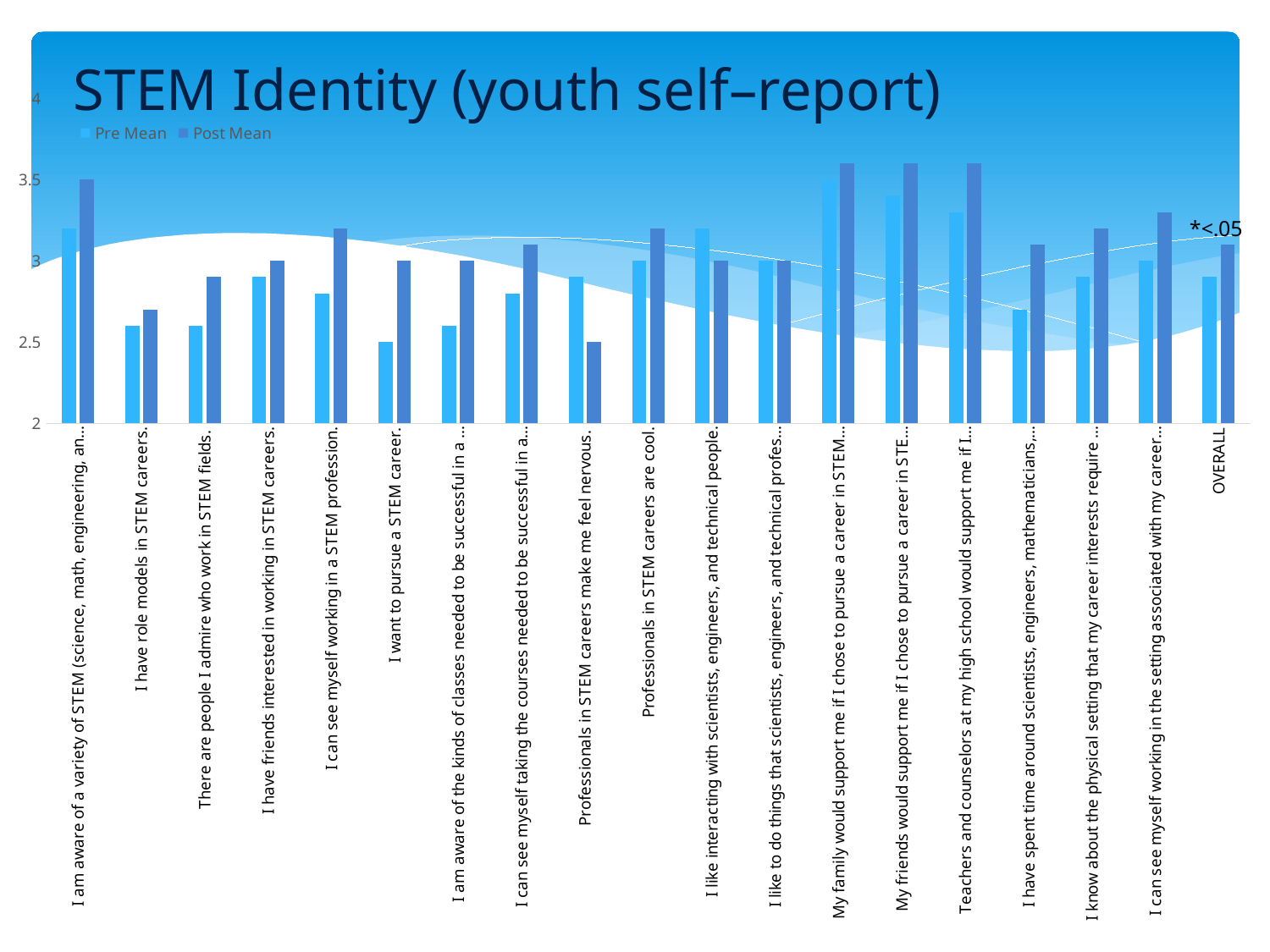
What are the two series named in the legend? Pre Mean and Post Mean How many categories are plotted along the x axis? 19 Is the Pre Mean for 'My friends would support me if I chose to pursue a career in STE...' greater or less than 3.5? less For 'Professionals in STEM careers make me feel nervous.', which is larger, the Pre Mean or the Post Mean? Pre Mean Is the Post Mean for 'My family would support me if I chose to pursue a career in STEM...' greater or less than 3.5? greater What kind of chart is shown on the slide? bar chart What is the title of the chart? STEM Identity (youth self-report) How many series does the legend list? 2 Is the Post Mean for OVERALL greater or less than 3? greater For 'I have spent time around scientists, engineers, mathematicians,...', which is larger, the Pre Mean or the Post Mean? Post Mean Which category has the lowest Post Mean? Professionals in STEM careers make me feel nervous.